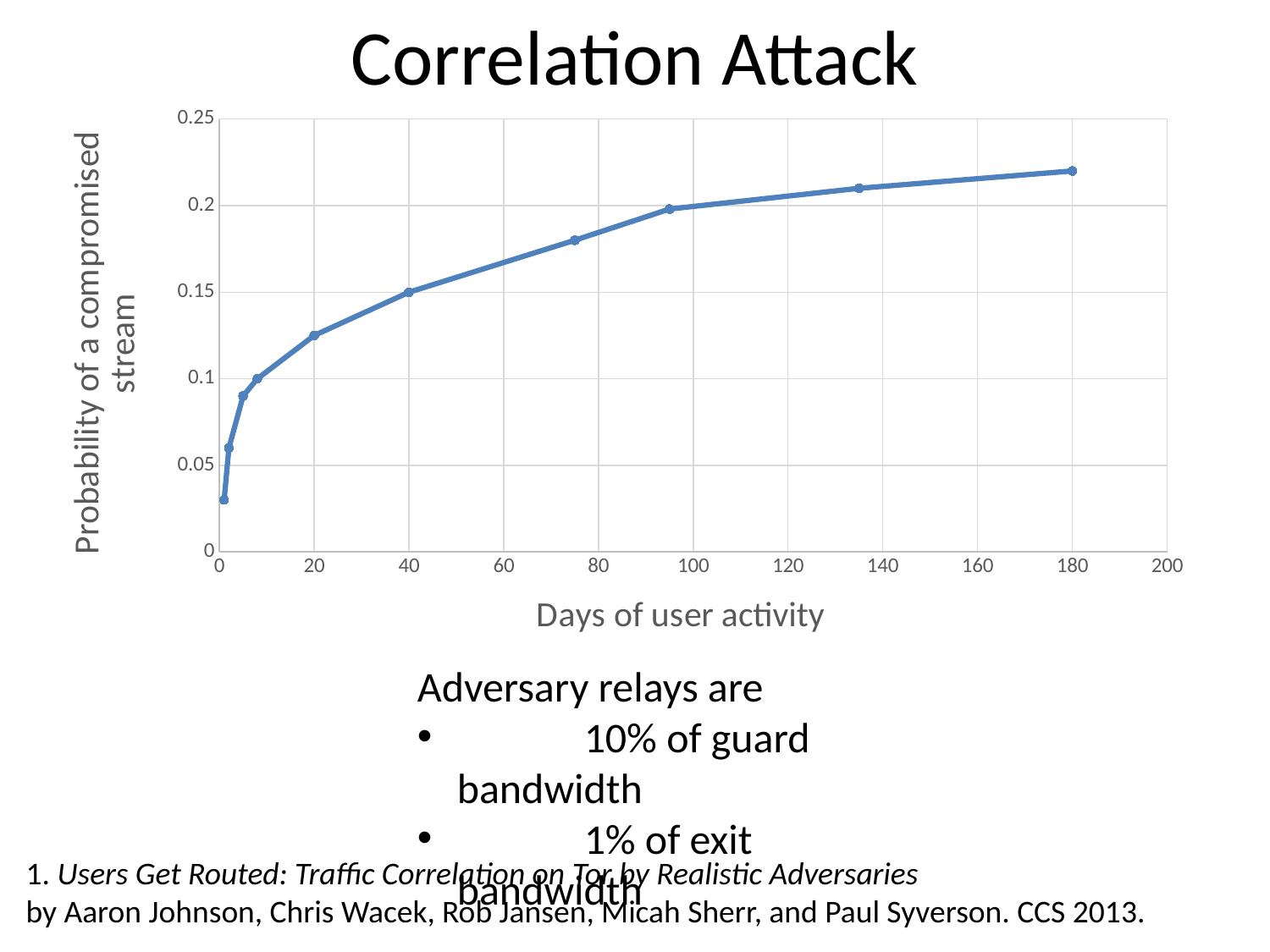
What is the label of the x axis? Days of user activity At how many days of user activity is the probability of a compromised stream highest? 180 Is the probability of a compromised stream at 20 days greater or less than 0.15? less Which has a higher probability of a compromised stream: 20 days or 95 days of user activity? 95 days Is the probability of a compromised stream at 180 days greater or less than 0.2? greater What kind of chart is shown on the slide? line chart Is the probability of a compromised stream at 135 days greater or less than 0.2? greater What is the probability of a compromised stream at 40 days of user activity? 0.15 What is the label of the y axis? Probability of a compromised stream Does the probability of a compromised stream rise or fall as days of user activity increase? rise